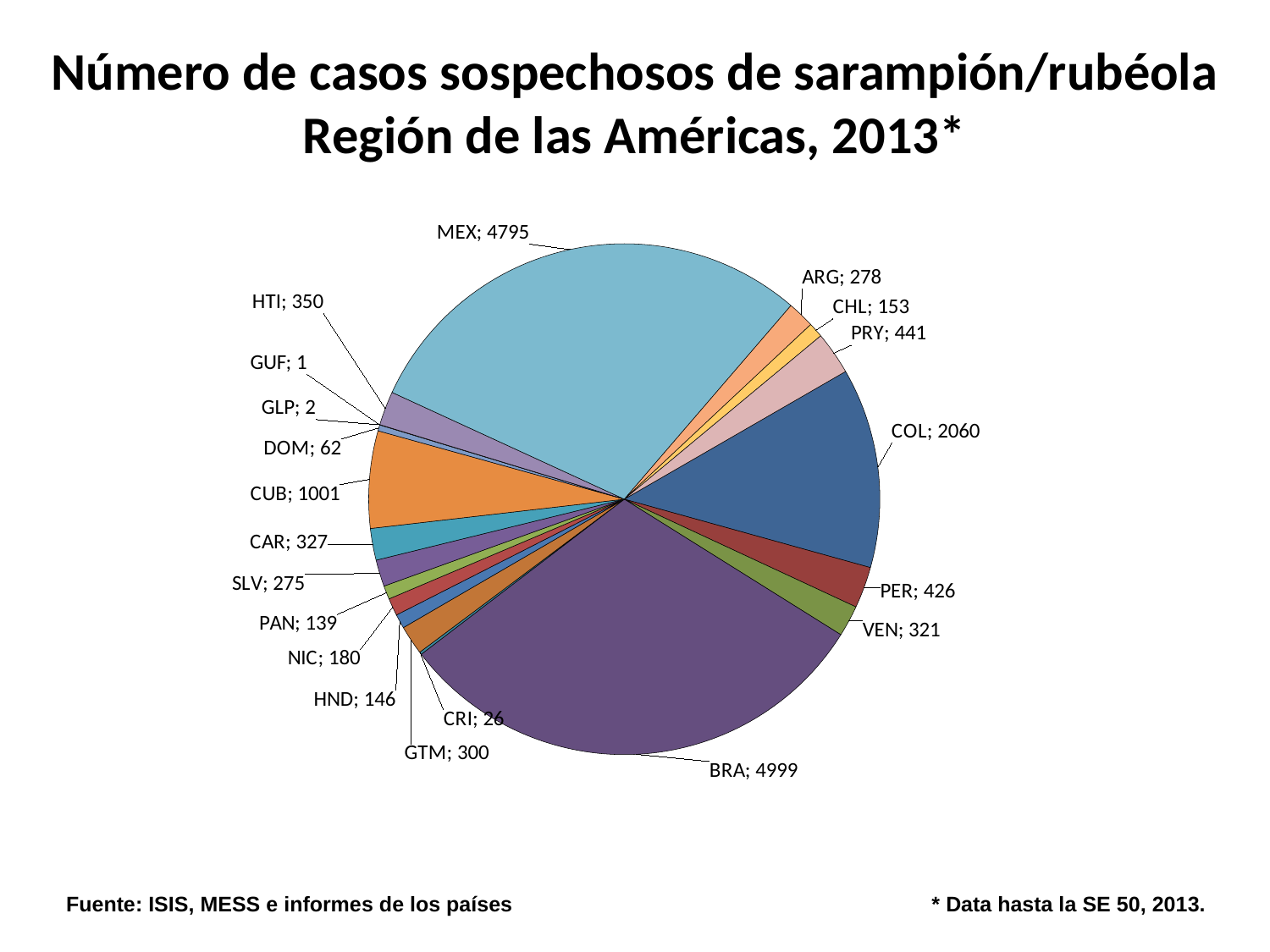
What is the difference between the values for BRA and MEX? 204 What is the value shown for CUB? 1001 What kind of chart is shown on the slide? Pie chart What is the value shown for HTI? 350 How many suspected cases are shown for MEX? 4795 How many slices (categories) does the pie chart have? 20 What is the difference between the values for COL and CUB? 1059 What is the title of the chart on the slide? Número de casos sospechosos de sarampión/rubéola Región de las Américas, 2013* Which category has the smallest value in the chart? GUF What is the value shown for COL? 2060 Which has a larger value, PER or PRY? PRY Which country has the largest slice of the pie? BRA